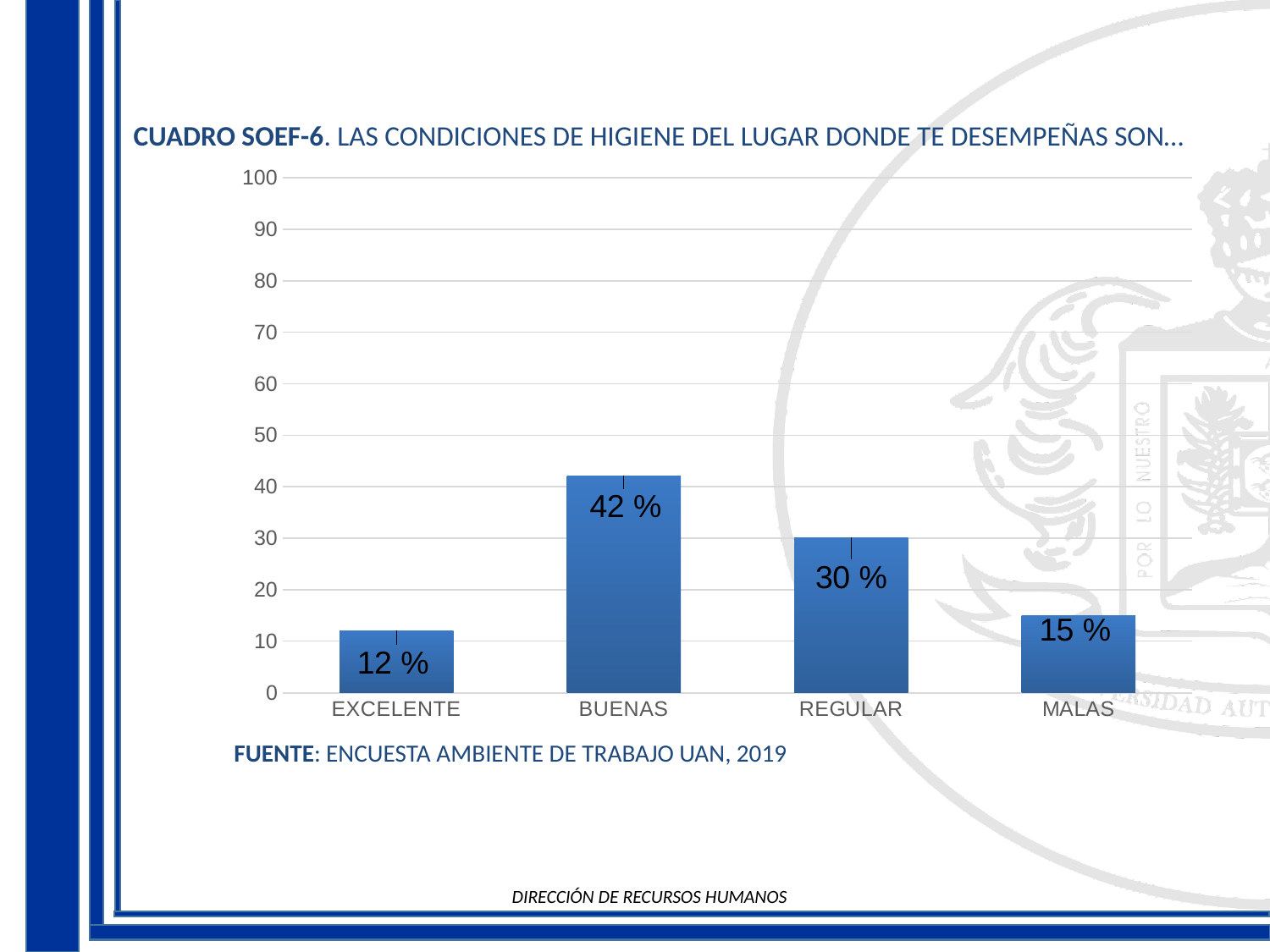
What is the difference between the values for BUENAS and REGULAR? 12 % What is the source cited below the chart? ENCUESTA AMBIENTE DE TRABAJO UAN, 2019 What is the value for MALAS? 15 % How many categories are shown on the x axis? 4 What is the value for EXCELENTE? 12 % What is the maximum value shown on the y axis? 100 Which category has the lowest value? EXCELENTE What kind of chart is shown on the slide? bar chart Is the value for REGULAR greater or less than 20? greater Which category has the highest value? BUENAS Which is larger, the value for MALAS or the value for EXCELENTE? MALAS What is the value for BUENAS? 42 %